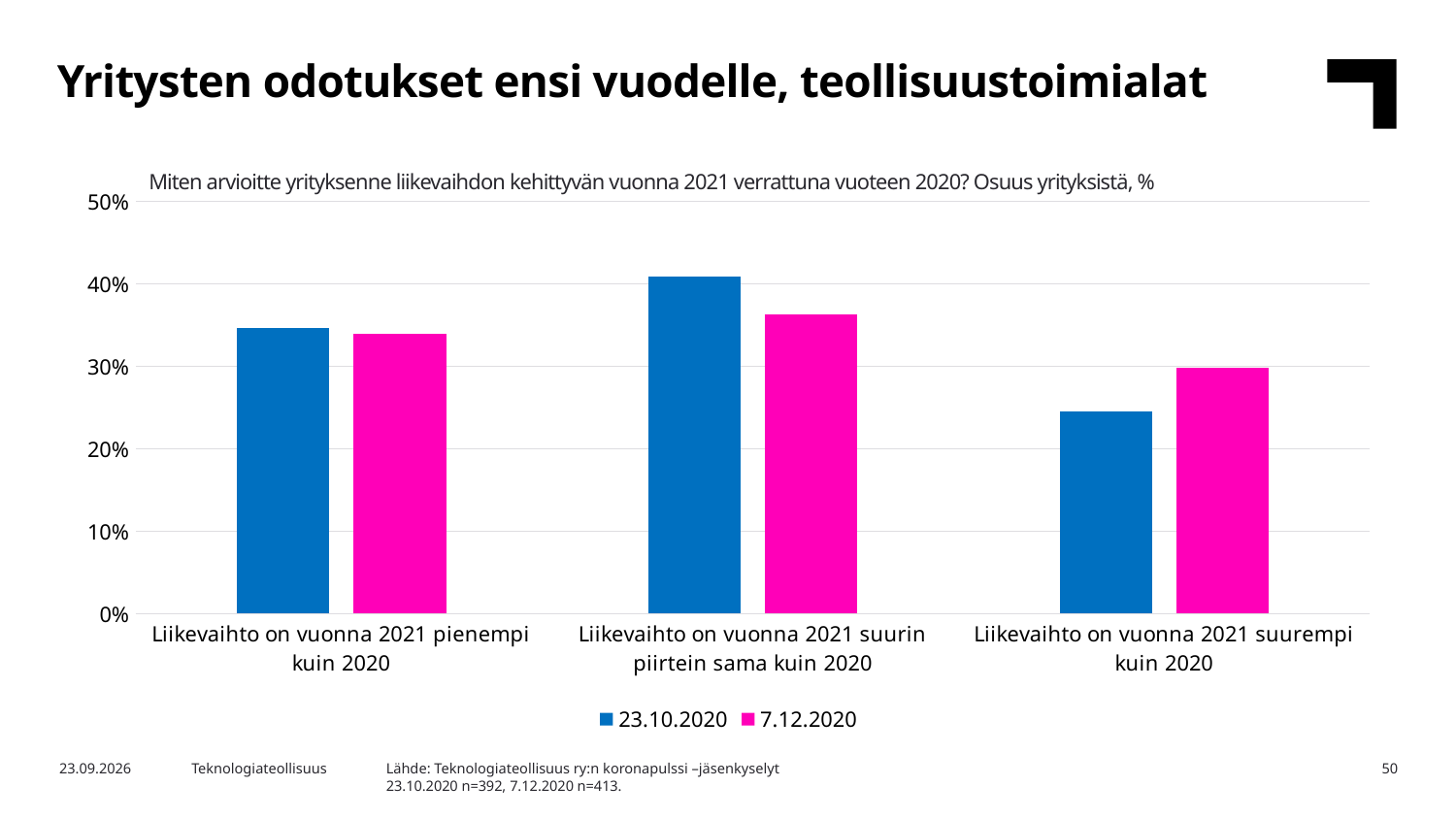
Is the 23.10.2020 value for 'Liikevaihto on vuonna 2021 suurempi kuin 2020' greater or less than 30%? less Is the 23.10.2020 value for 'Liikevaihto on vuonna 2021 suurin piirtein sama kuin 2020' greater or less than 40%? greater What kind of chart is shown on the slide? bar chart How many series does the legend list? 2 For 'Liikevaihto on vuonna 2021 suurin piirtein sama kuin 2020', which series has the larger value, 23.10.2020 or 7.12.2020? 23.10.2020 For 'Liikevaihto on vuonna 2021 suurempi kuin 2020', which series has the larger value, 23.10.2020 or 7.12.2020? 7.12.2020 Which category has the highest value for the 23.10.2020 series? Liikevaihto on vuonna 2021 suurin piirtein sama kuin 2020 How many categories are shown on the x axis? 3 Which category has the lowest value for the 23.10.2020 series? Liikevaihto on vuonna 2021 suurempi kuin 2020 What colour are the bars for the 7.12.2020 series? magenta (pink) Is the 7.12.2020 value for 'Liikevaihto on vuonna 2021 pienempi kuin 2020' greater or less than 30%? greater Which category has the lowest value for the 7.12.2020 series? Liikevaihto on vuonna 2021 suurempi kuin 2020